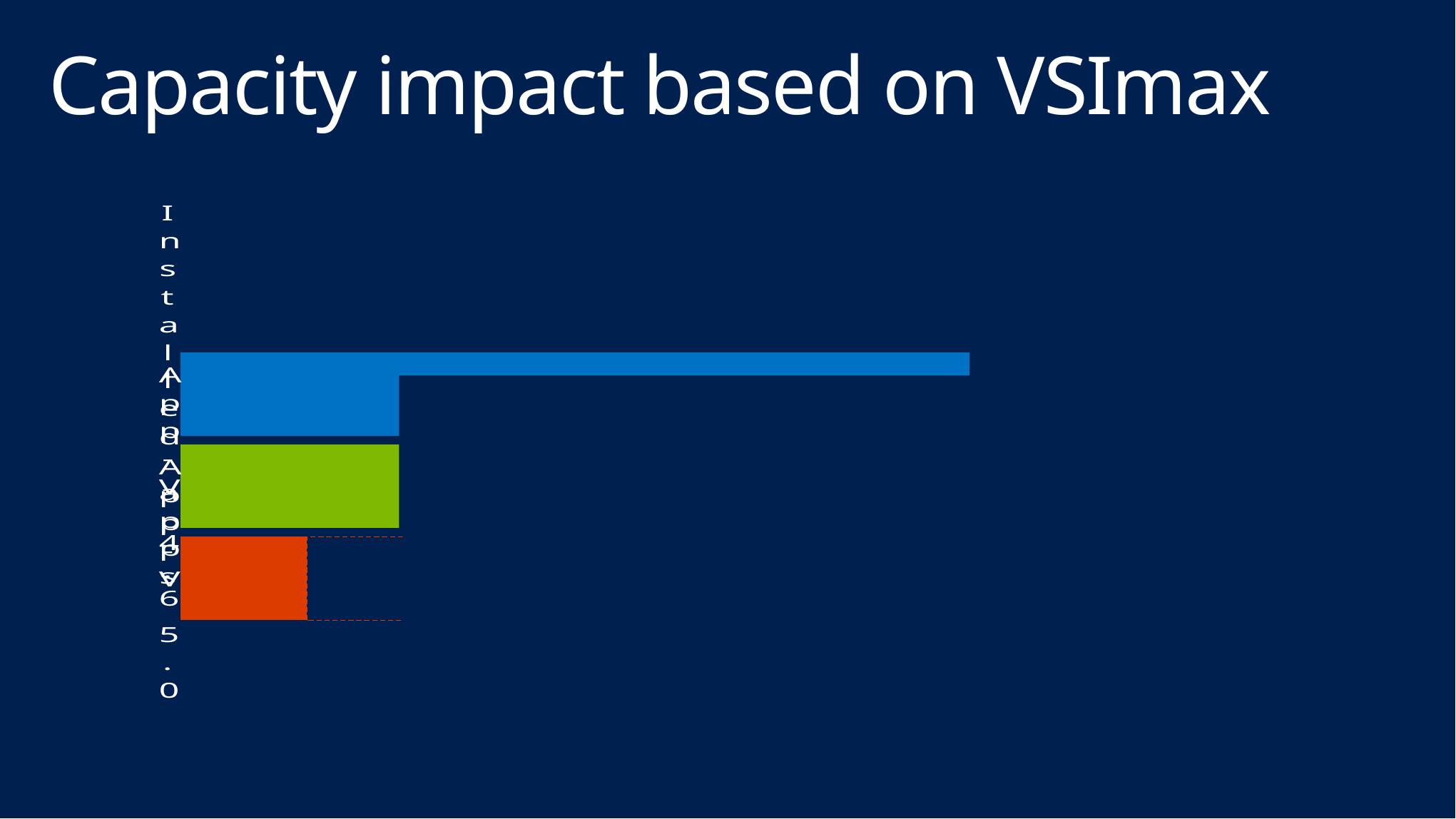
What colour is the bottom bar of the chart? red What is the title of the slide containing the chart? Capacity impact based on VSImax Which is larger, the middle (green) bar or the bottom (red) bar? the middle (green) bar How many bars does the chart show? 3 Which bar is the shortest: the top (blue), middle (green) or bottom (red) bar? the bottom (red) bar Which bar is the longest: the top (blue), middle (green) or bottom (red) bar? the top (blue) bar What kind of chart is shown on the slide? bar chart Are the bars in the chart horizontal or vertical? horizontal Which is larger, the top (blue) bar or the bottom (red) bar? the top (blue) bar